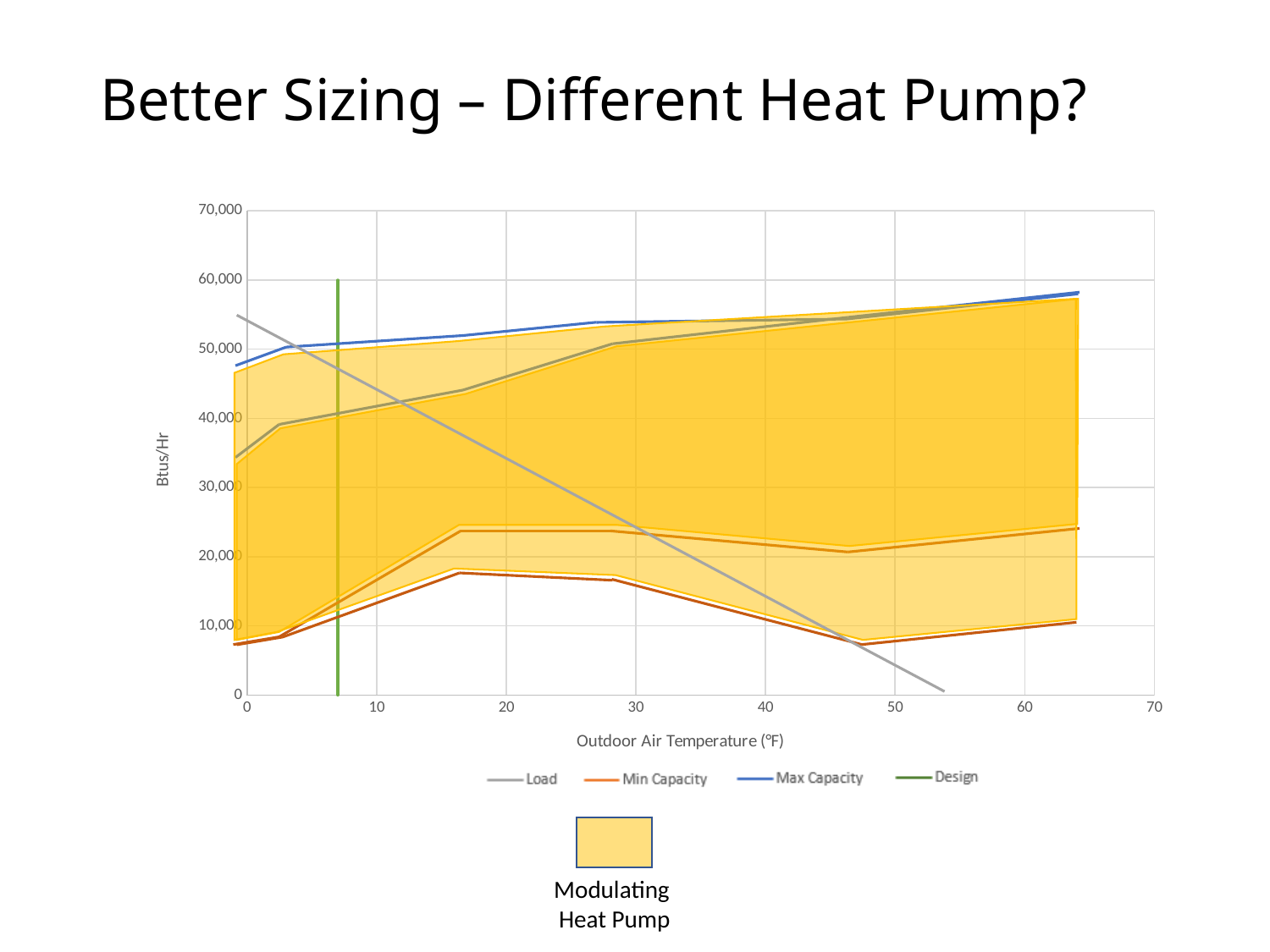
What are the series names listed in the chart legend? Load, Min Capacity, Max Capacity, Design At 64°F, which is larger: the Max Capacity value or the Min Capacity value? Max Capacity Does the Load series rise or fall as outdoor air temperature increases? fall Is the Load value at 0°F greater or less than 50,000 Btus/Hr? greater Is the Load value at 50°F greater or less than 10,000 Btus/Hr? less Is the Max Capacity value at 64°F greater or less than 50,000 Btus/Hr? greater How many series does the chart legend list? 4 Does the Max Capacity series rise or fall as outdoor air temperature increases? rise What kind of chart is shown on the slide? line chart At 0°F, which is larger: the Load value or the Max Capacity value? Load What is the title of the vertical axis of the chart? Btus/Hr